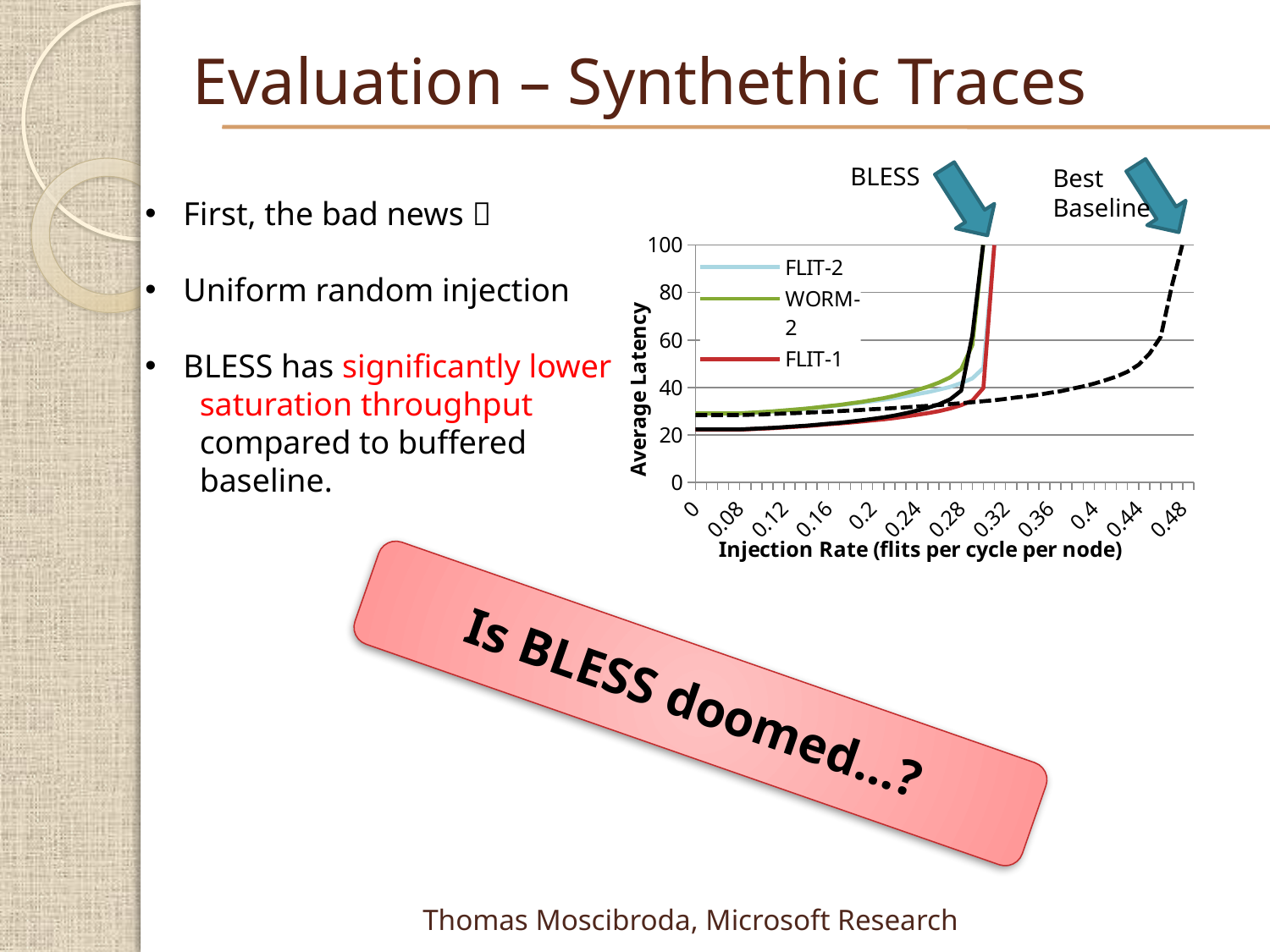
Which line reaches an average latency of 100 at a higher injection rate: the BLESS line or the Best Baseline line? Best Baseline Is the average latency for WORM-2 at an injection rate of 0.2 greater or less than 60? less Is the average latency for FLIT-1 at an injection rate of 0.2 greater or less than 40? less What is the highest value shown on the chart's vertical axis? 100 How many series does the chart's legend list? 3 Is the average latency for FLIT-2 at an injection rate of 0.08 greater or less than 40? less What kind of chart is shown on the slide? line chart What is the title of the chart's vertical axis? Average Latency What is the highest injection rate labelled on the chart's horizontal axis? 0.48 As the injection rate increases along the x axis, does the average latency rise or fall? rise Which series are listed in the chart's legend? FLIT-2, WORM-2, FLIT-1